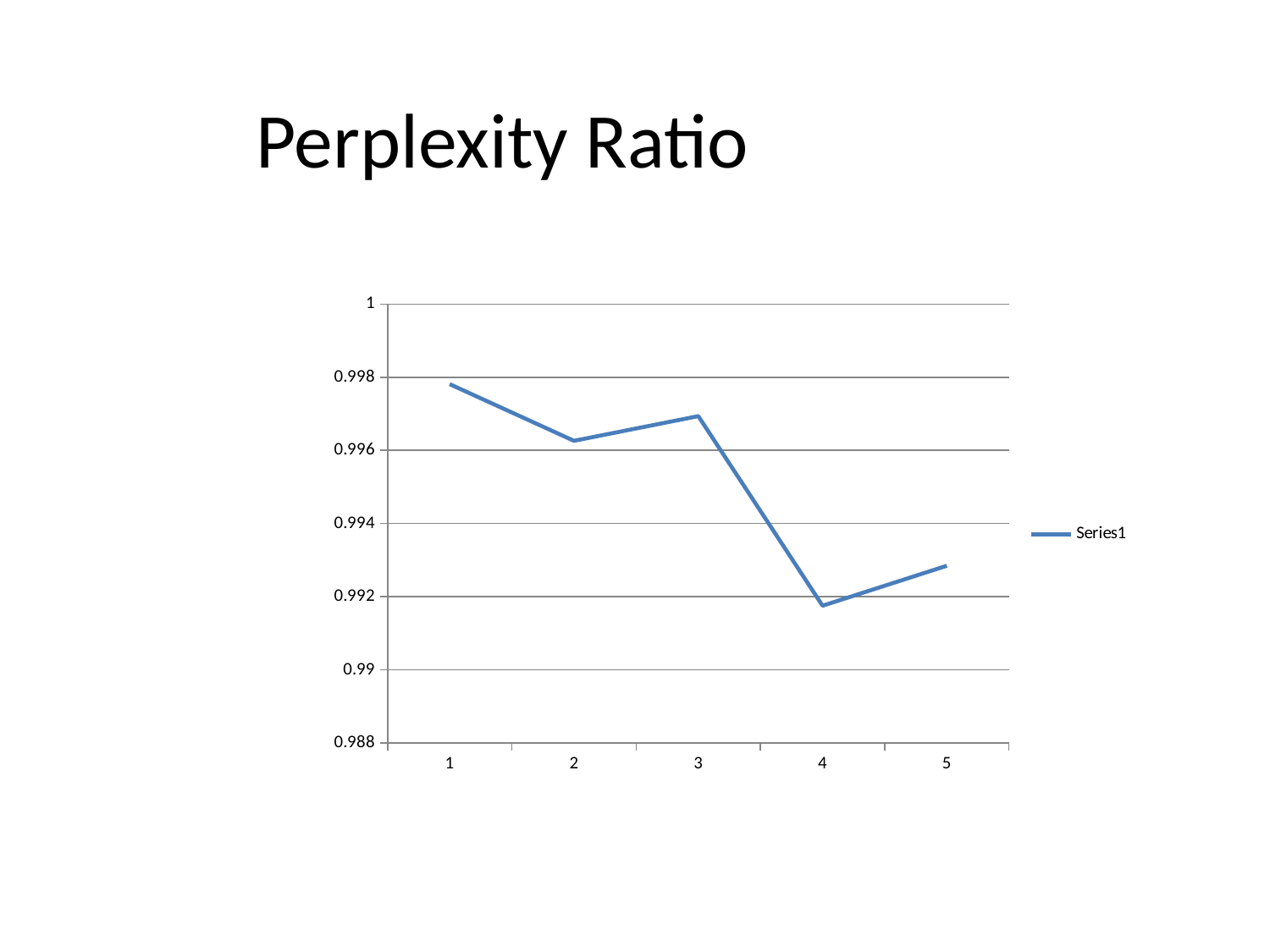
How many series does the legend list? 1 At which x-axis category is the value lowest? 4 Overall, do the values rise or fall from x = 1 to x = 5? fall Is the value at x = 5 greater or less than 0.994? less Is the value at x = 1 greater or less than 0.996? greater Is the value at x = 4 greater or less than 0.994? less What is the title of the chart? Perplexity Ratio How many points are plotted along the x axis? 5 Which has the larger value, x = 4 or x = 5? 5 What is the name of the series shown in the legend? Series1 At which x-axis category is the value highest? 1 What kind of chart is shown on the slide? line chart